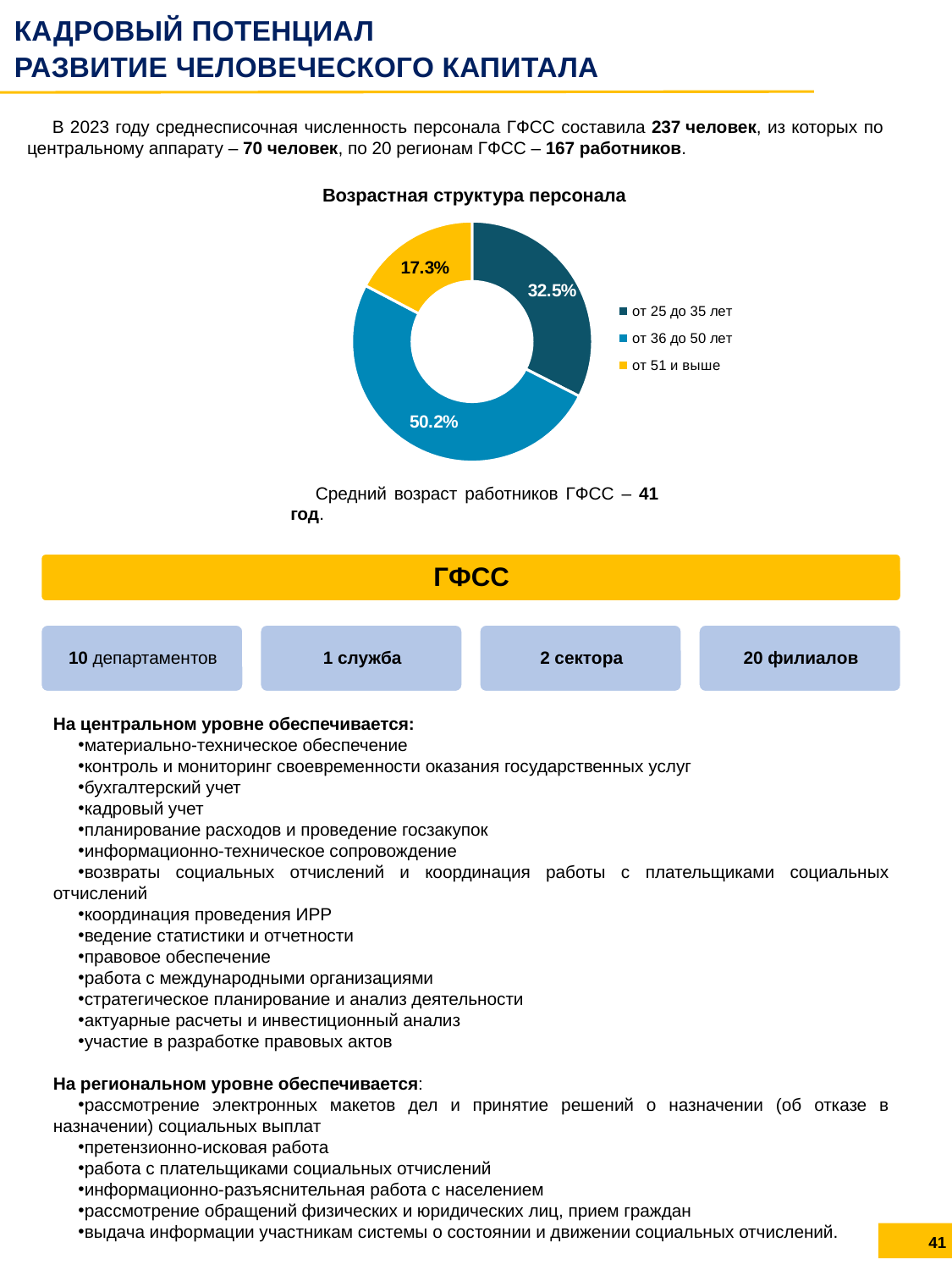
In the 'Возрастная структура персонала' chart, what is the difference in percentage points between the 25–35 group and the 51 and above group? 15.2 In the 'Возрастная структура персонала' chart, what is the difference in percentage points between the 36–50 group and the 25–35 group? 17.7 What share of staff is aged 36 to 50 (от 36 до 50 лет) in the 'Возрастная структура персонала' chart? 50.2% What is the title of the chart on the slide? Возрастная структура персонала Which age group has the smallest share in the 'Возрастная структура персонала' chart? от 51 и выше How many age groups are shown in the 'Возрастная структура персонала' chart? 3 Which age group has the largest share in the 'Возрастная структура персонала' chart? от 36 до 50 лет What share of staff is aged 51 and above (от 51 и выше) in the 'Возрастная структура персонала' chart? 17.3% What type of chart is 'Возрастная структура персонала'? doughnut (pie) chart What colour represents the 'от 51 и выше' group in the 'Возрастная структура персонала' chart? yellow In the 'Возрастная структура персонала' chart, which is larger: the share of staff aged 25 to 35 or the share aged 51 and above? от 25 до 35 лет What share of staff is aged 25 to 35 (от 25 до 35 лет) in the 'Возрастная структура персонала' chart? 32.5%